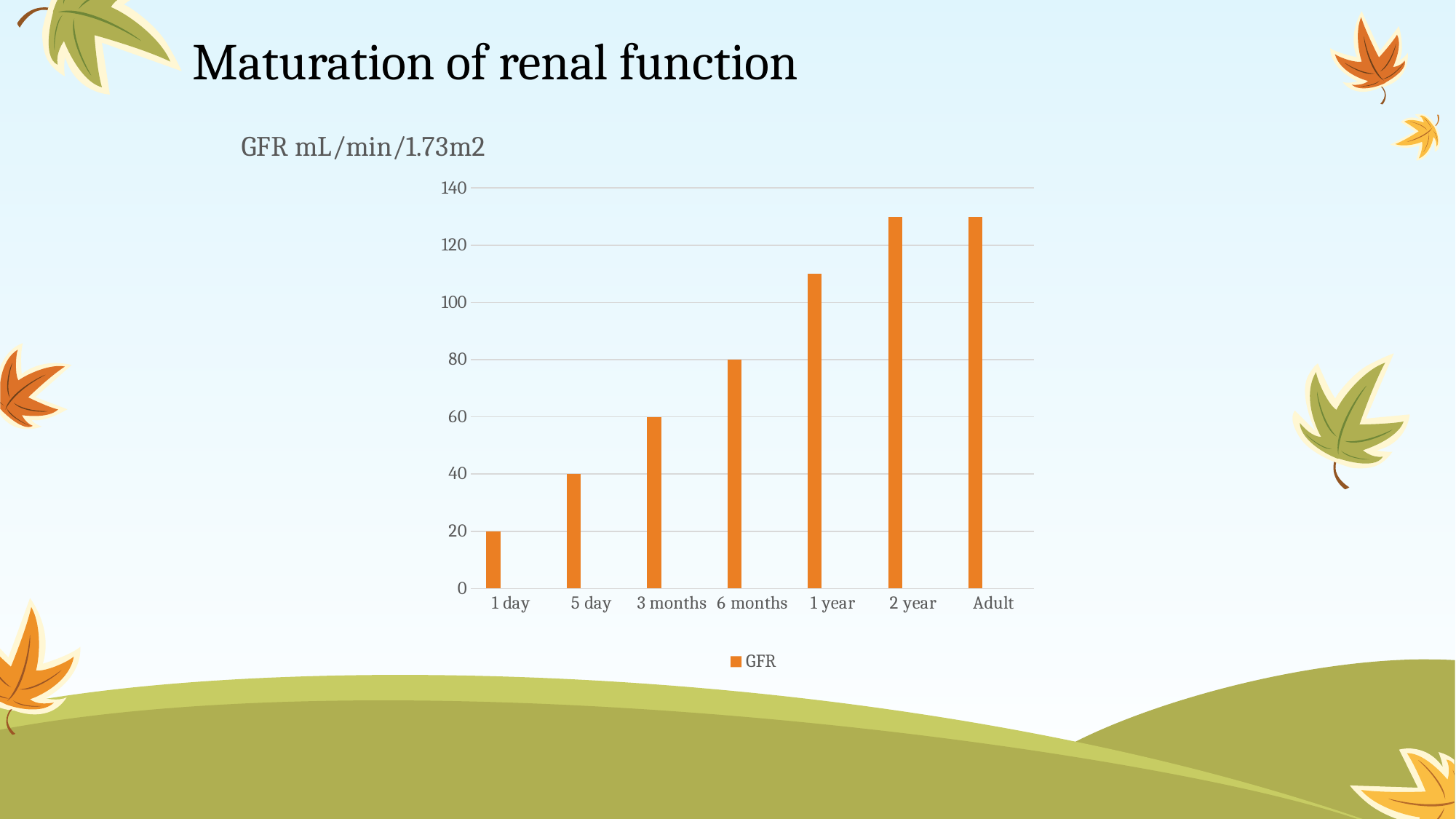
How many categories are shown on the x axis? 7 Is the GFR value for Adult greater or less than 120? greater What is the GFR value for 6 months? 80 What kind of chart is shown on the slide? Bar chart What is the GFR value for 5 day? 40 Which has a larger GFR value, 1 year or 3 months? 1 year What is the GFR value for 1 day? 20 Do the GFR values rise or fall from 1 day to 2 year? Rise What is the difference between the GFR values for 6 months and 1 day? 60 What is the GFR value for 3 months? 60 Is the GFR value for 1 year greater or less than 100? greater Which category has the lowest GFR value? 1 day